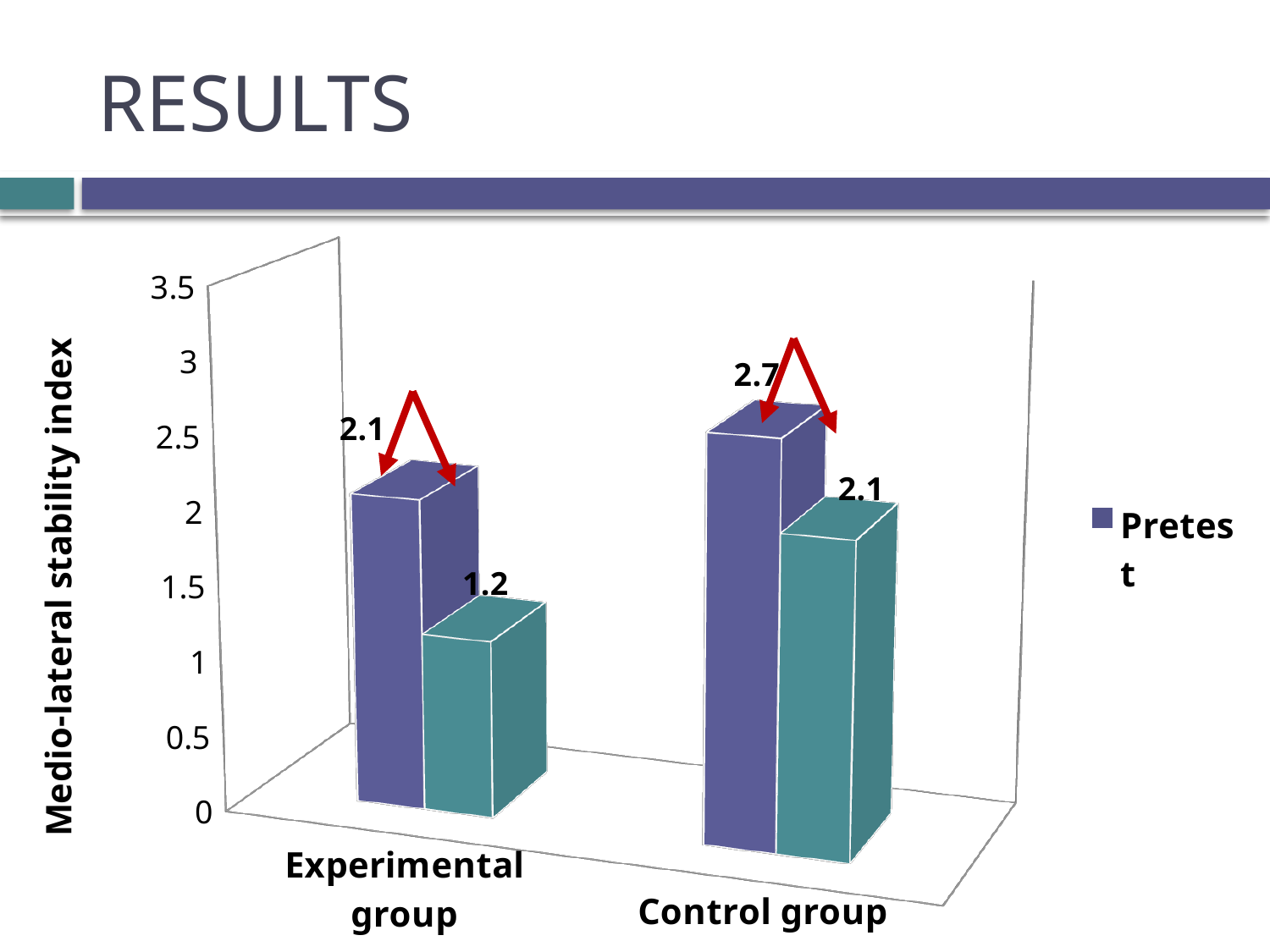
What is the value of the teal (second) bar for the Experimental group? 1.2 How many groups (categories) are shown on the x axis? 2 What is the value of the teal (second) bar for the Control group? 2.1 For the Experimental group, what is the difference between the Pretest bar and the teal bar? 0.9 What is the label of the vertical axis? Medio-lateral stability index What is the difference between the Control group's Pretest value and the Experimental group's Pretest value? 0.6 What kind of chart is shown on the slide? Bar chart What is the Pretest value for the Experimental group? 2.1 Which group has the higher Pretest value? Control group Which bar shows the lowest value on the chart? The teal bar for the Experimental group (1.2) What is the Pretest value for the Control group? 2.7 Is the Pretest value for the Control group greater or less than 2.5? greater